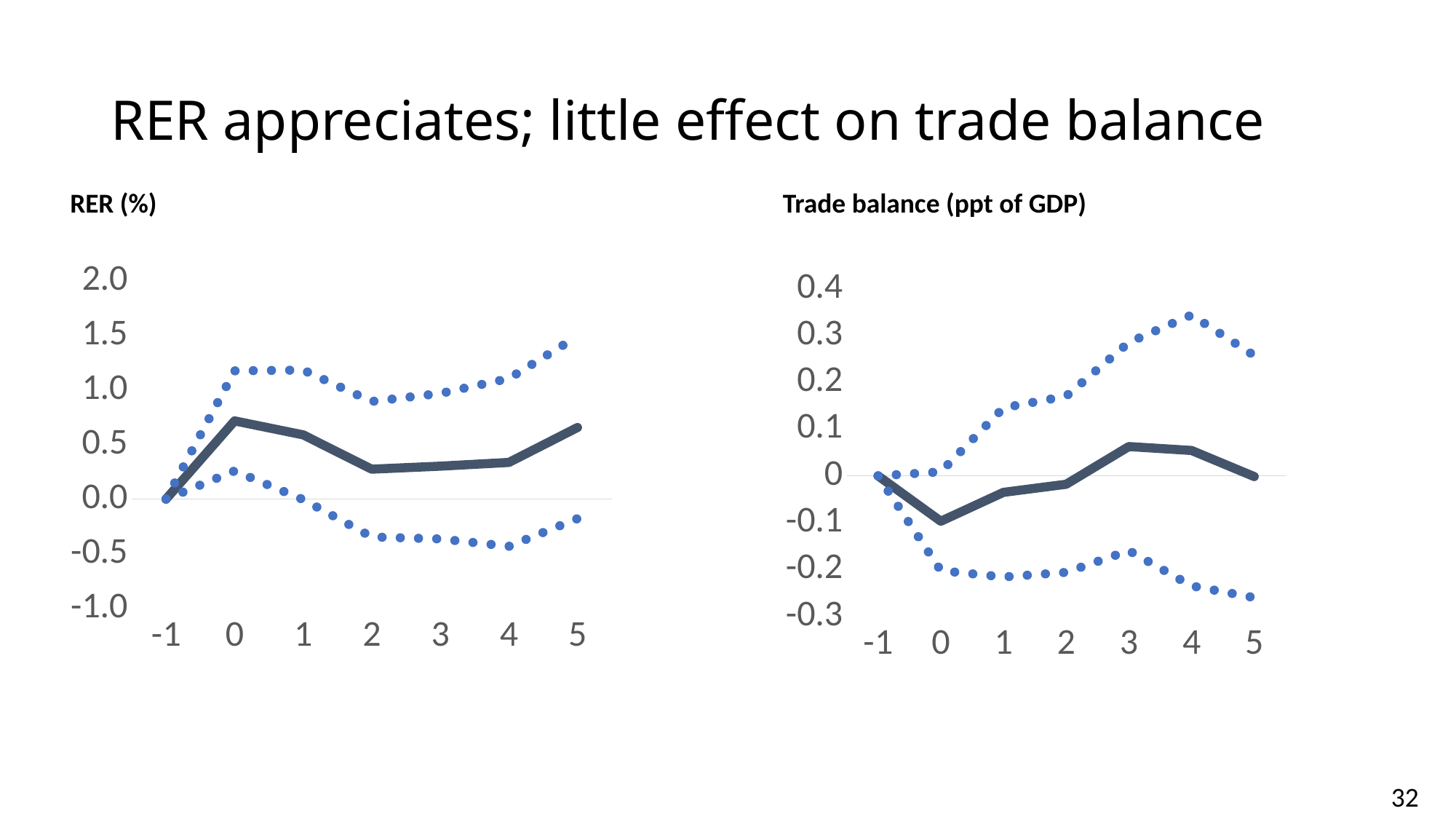
In the RER (%) chart, is the solid line higher at x = 0 or at x = 2? 0 What kind of chart is the RER (%) chart? line chart In the RER (%) chart, at which x value is the solid line lowest? -1 In the RER (%) chart, is the value of the solid line at x = 2 greater or less than 0.5? less In the RER (%) chart, is the value of the solid line at x = 0 greater or less than 0.5? greater In the Trade balance (ppt of GDP) chart, is the value of the upper dotted line at x = 4 greater or less than 0.3? greater In the Trade balance (ppt of GDP) chart, what is the value of the solid line at x = -1? 0 How many x-axis points are plotted in the Trade balance (ppt of GDP) chart? 7 In the RER (%) chart, what is the value of the solid line at x = -1? 0.0 In the RER (%) chart, at which x value does the solid line reach its highest point? 0 In the Trade balance (ppt of GDP) chart, at which x value is the solid line lowest? 0